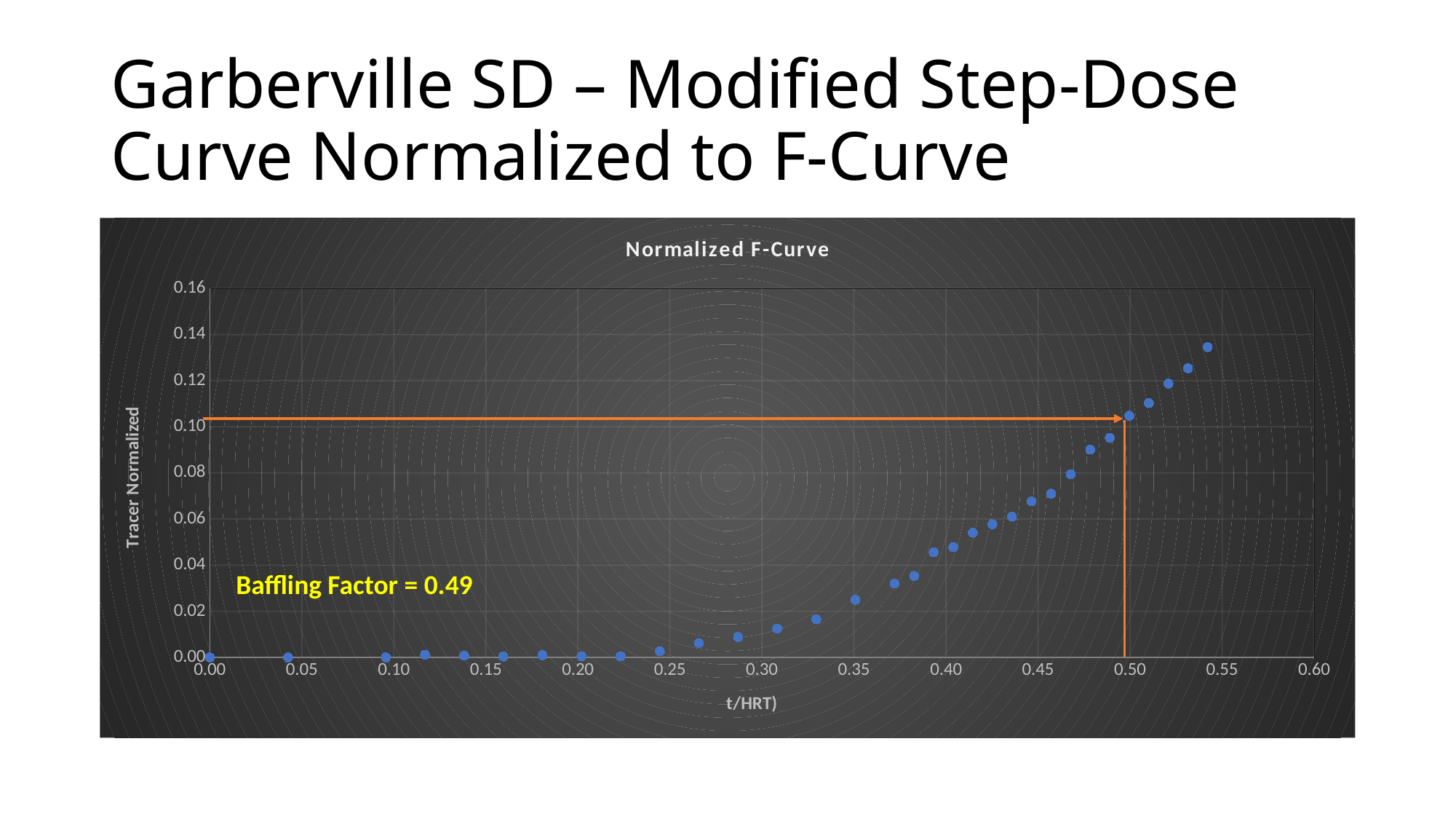
What is the title of the chart? Normalized F-Curve What kind of chart is shown on the slide? Scatter chart What is the Tracer Normalized value at t/HRT = 0.00? 0.00 Is the Tracer Normalized value at t/HRT = 0.40 greater or less than 0.06? less What Baffling Factor is stated on the chart? 0.49 What is the maximum value shown on the y axis? 0.16 Is the Tracer Normalized value at t/HRT = 0.50 greater or less than 0.08? greater Do the plotted values rise or fall as t/HRT increases from 0.25 to 0.55? Rise Is the Tracer Normalized value at t/HRT = 0.30 greater or less than 0.02? less What is the label of the y axis? Tracer Normalized Which is larger, the Tracer Normalized value at t/HRT = 0.35 or at t/HRT = 0.45? t/HRT = 0.45